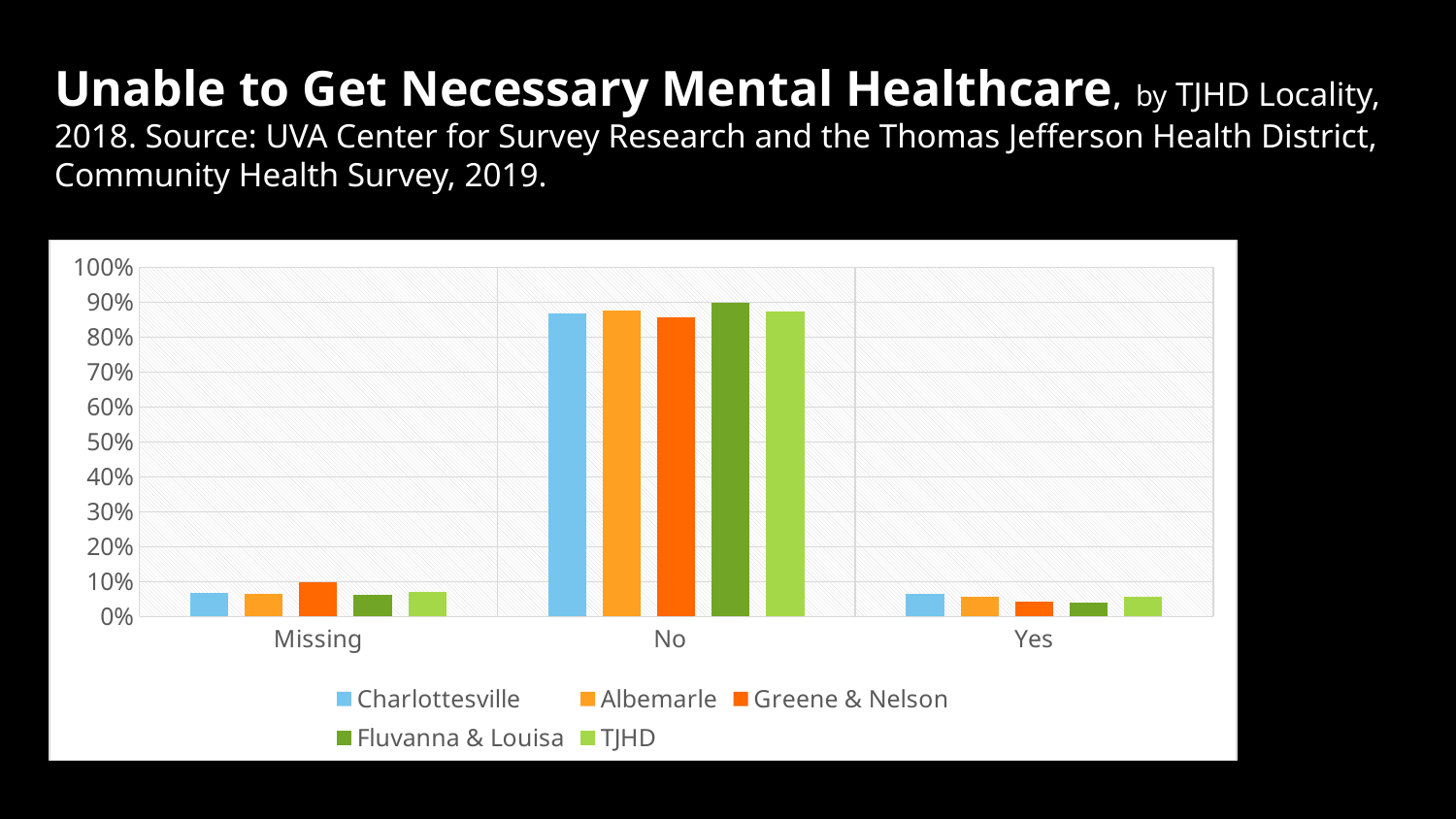
Which series has the highest bar in the "Missing" category? Greene & Nelson How many series does the legend list? 5 Which category has the tallest bars overall: Missing, No, or Yes? No Which series has the highest bar in the "No" category? Fluvanna & Louisa Is the value for Charlottesville in the "Yes" category greater or less than 10%? less Which series is shown in light blue in the legend? Charlottesville Is the value for Fluvanna & Louisa in the "No" category greater or less than 80%? greater Which series has the lowest bar in the "No" category? Greene & Nelson What kind of chart is shown on the slide? Bar chart Which is larger for Greene & Nelson: the "Missing" bar or the "Yes" bar? Missing Is the value for Albemarle in the "Missing" category greater or less than 10%? less How many categories are shown along the x axis? 3